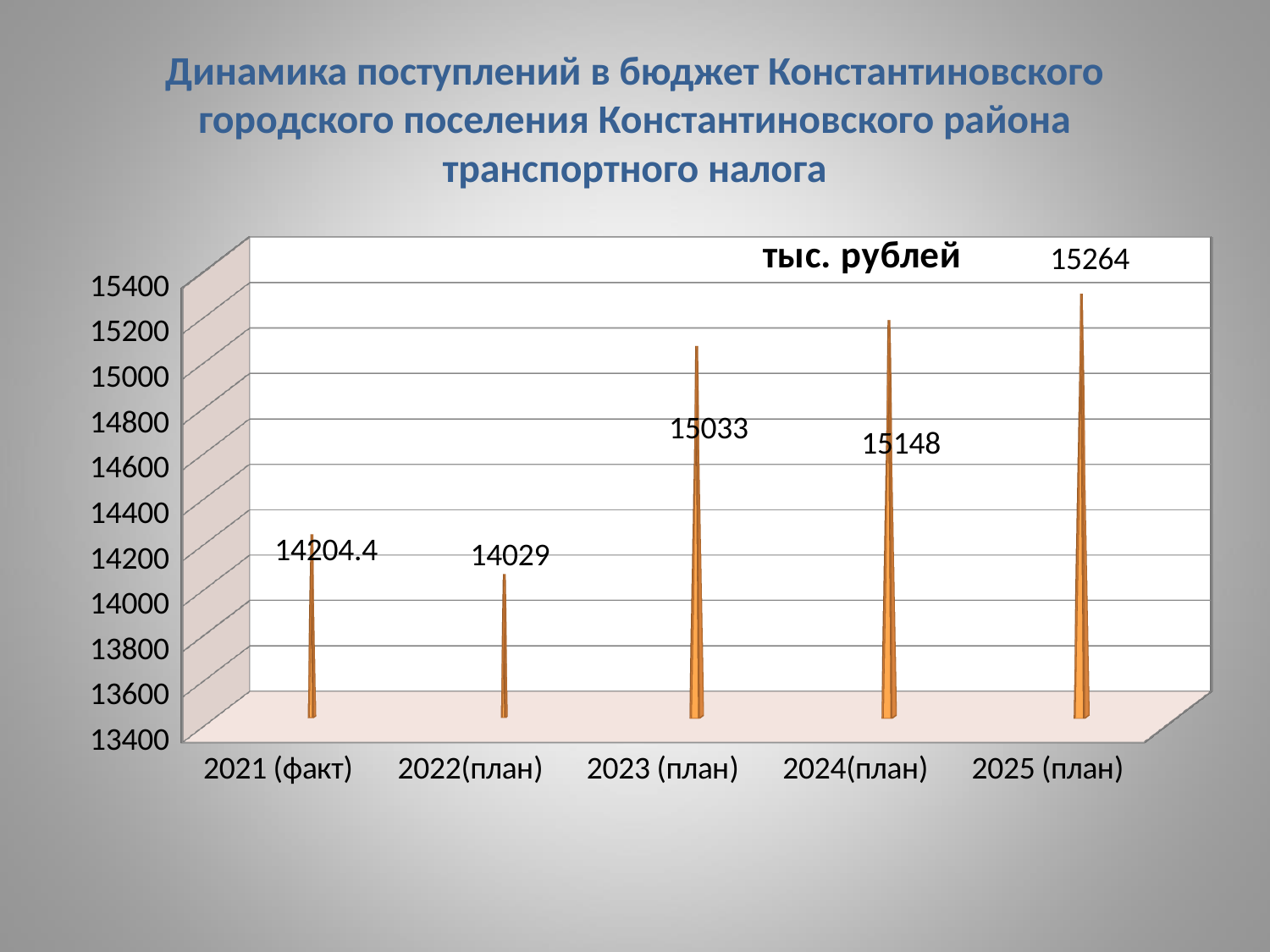
What is the value for 2022(план)? 14029 What kind of chart is this? bar chart What is the value for 2025 (план)? 15264 In what units are the values given, according to the label on the chart? тыс. рублей Which is larger, the value for 2021 (факт) or the value for 2022(план)? 2021 (факт) What is the difference between the values for 2023 (план) and 2022(план)? 1004 Which year has the highest value? 2025 (план) What is the difference between the values for 2025 (план) and 2024(план)? 116 Which year has the lowest value? 2022(план) What is the value for 2023 (план)? 15033 How many years are shown on the x axis? 5 What is the value for 2021 (факт)? 14204.4